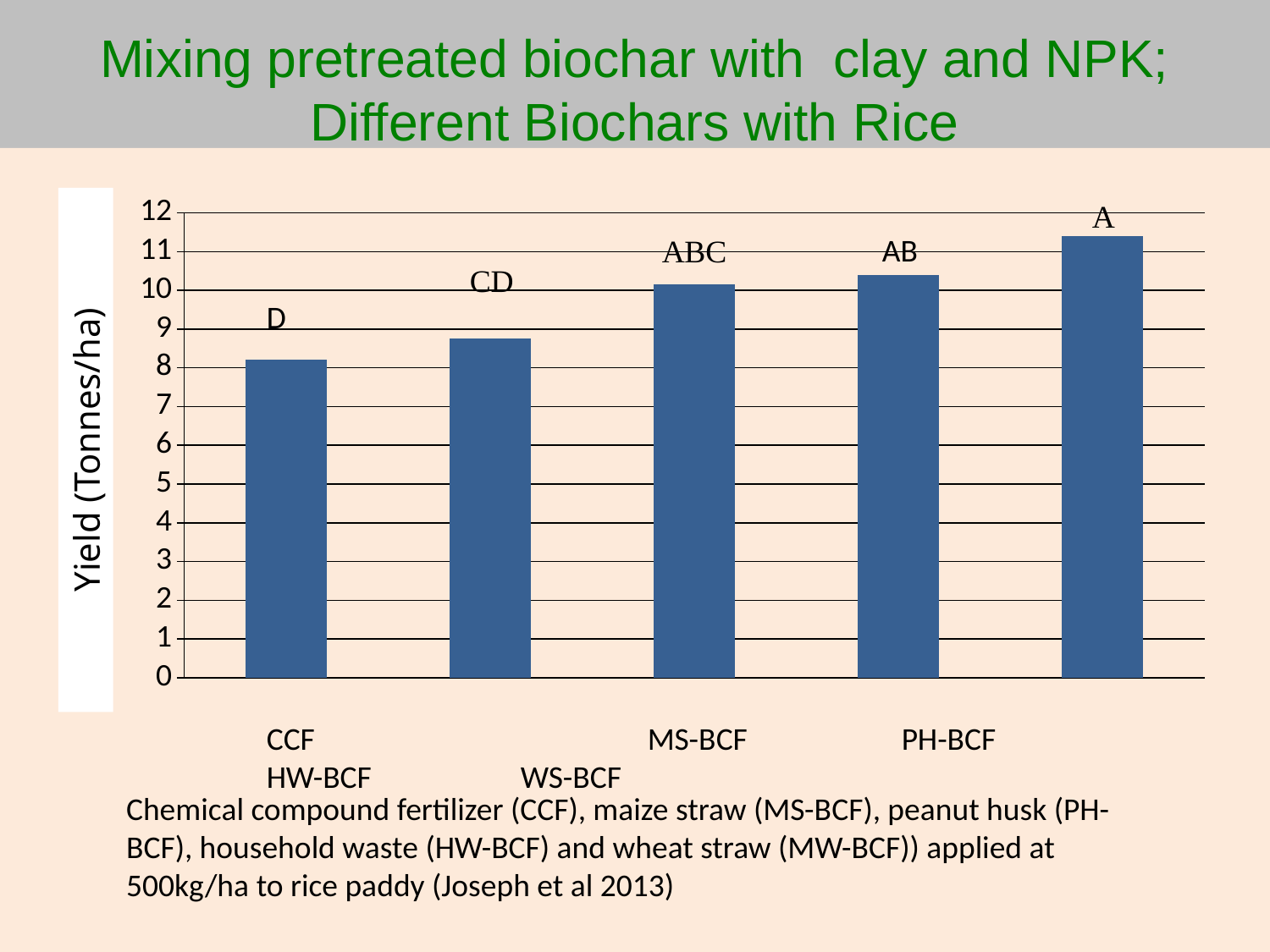
Which category has the lowest yield? CCF What kind of chart is shown on the slide? bar chart What is the label on the vertical axis of the chart? Yield (Tonnes/ha) Which has a higher yield, HW-BCF or MS-BCF? MS-BCF How many bars (categories) are plotted in the chart? 5 Do the yields rise or fall moving from left to right across the categories? rise Is the yield for MS-BCF greater or less than 10 tonnes/ha? greater Is the yield for HW-BCF greater or less than 9 tonnes/ha? less Is the yield for PH-BCF greater or less than 11 tonnes/ha? greater Which category has the highest yield? PH-BCF Which has a higher yield, CCF or PH-BCF? PH-BCF